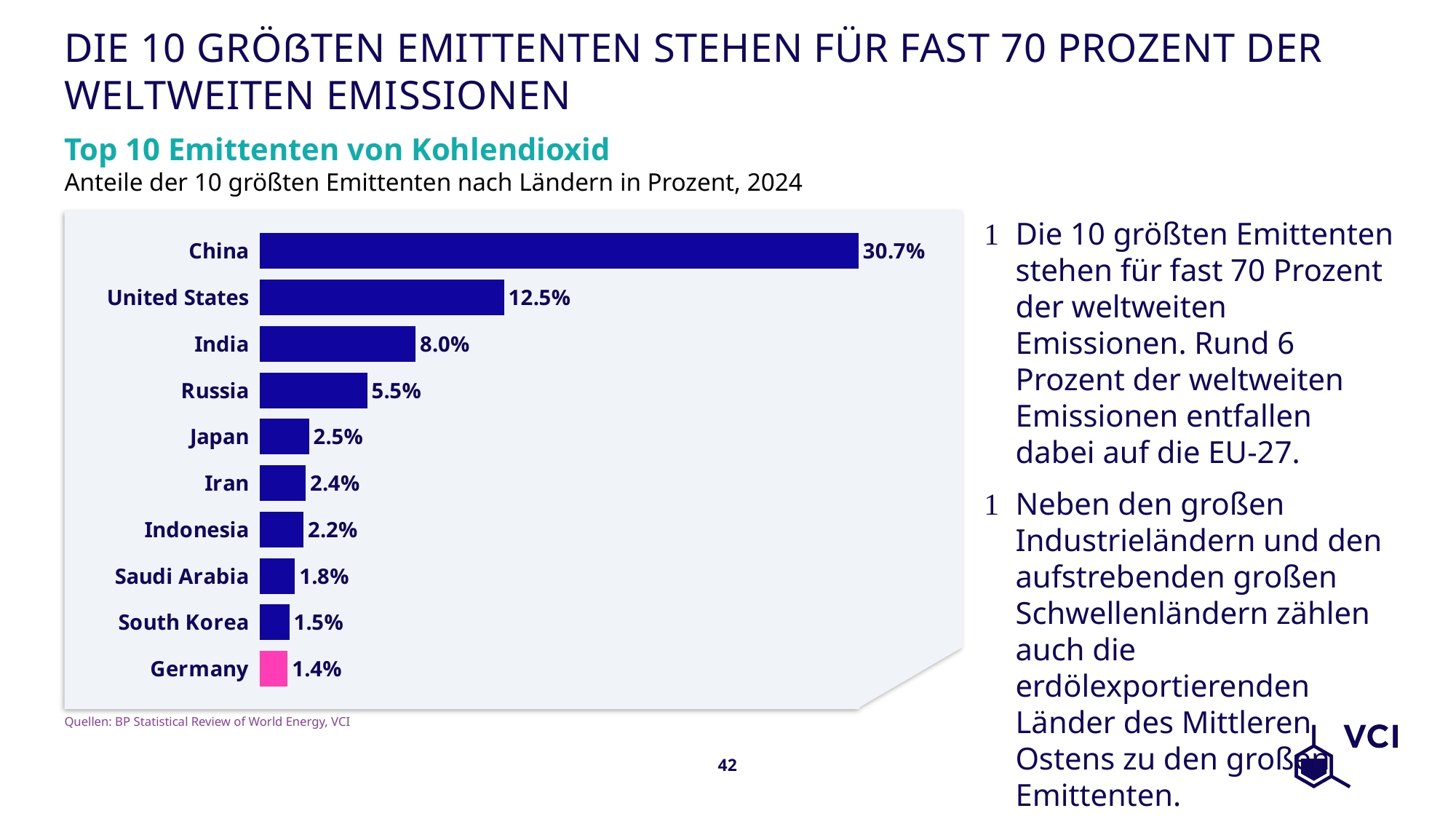
Which country's bar is shown in a different colour (pink) from the others? Germany How many countries are shown in the chart? 10 What is the value for India? 8.0% Which is larger, the value for Iran or the value for Indonesia? Iran What is the value for Germany? 1.4% Which country has the highest share? China What kind of chart is this? Bar chart What is the value for China? 30.7% What is the difference between the values for Russia and Japan? 3.0% What is the difference between the values for China and the United States? 18.2% What is the title of the chart? Top 10 Emittenten von Kohlendioxid Which country has the lowest share? Germany